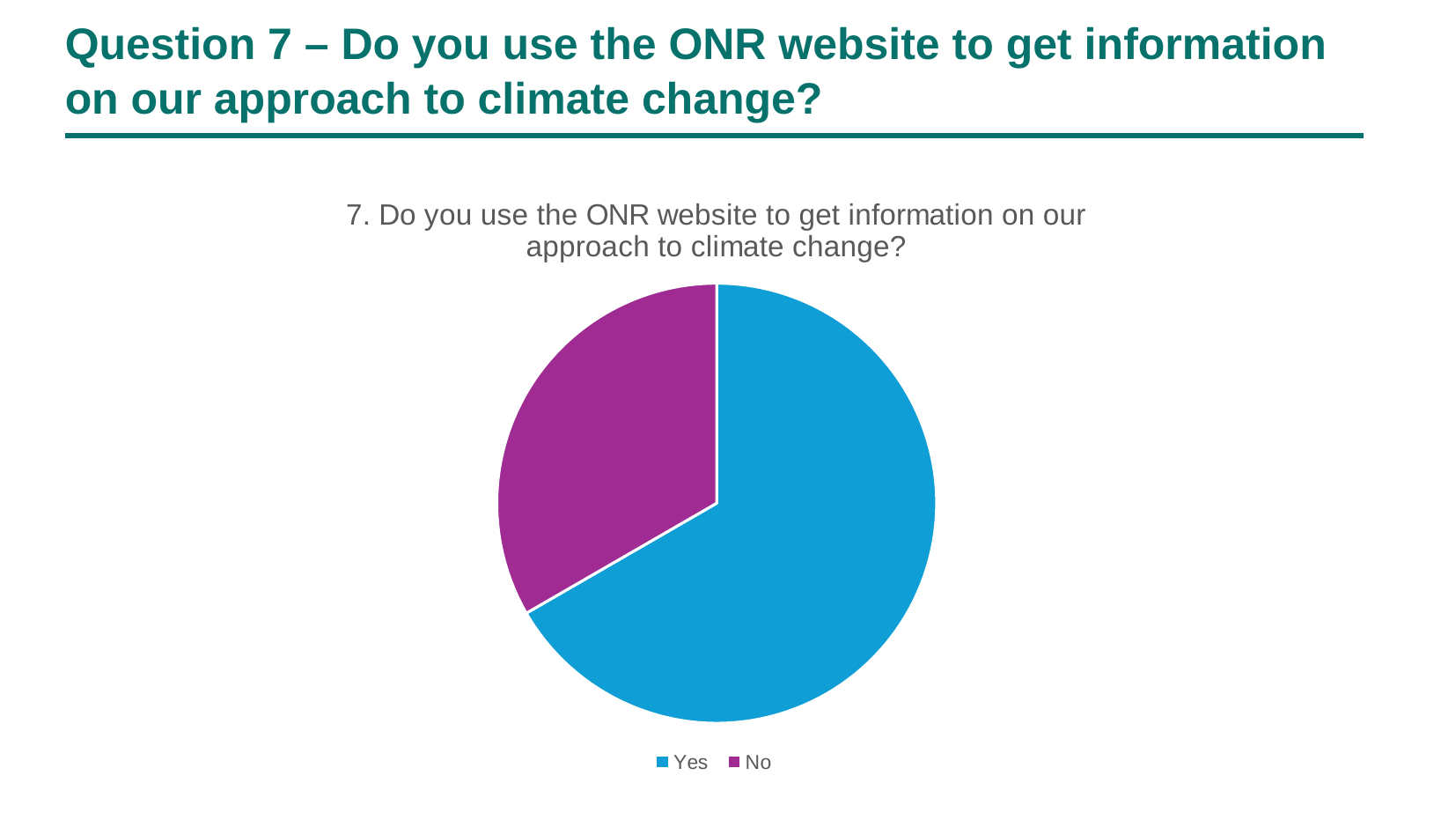
Which response has the largest slice of the pie? Yes What kind of chart is shown on the slide? pie chart Which slice is larger, Yes or No? Yes How many entries does the legend list? 2 Which response has the smallest slice of the pie? No What colour is the slice for No? purple What is the title of the chart? 7. Do you use the ONR website to get information on our approach to climate change? How many slices does the pie chart have? 2